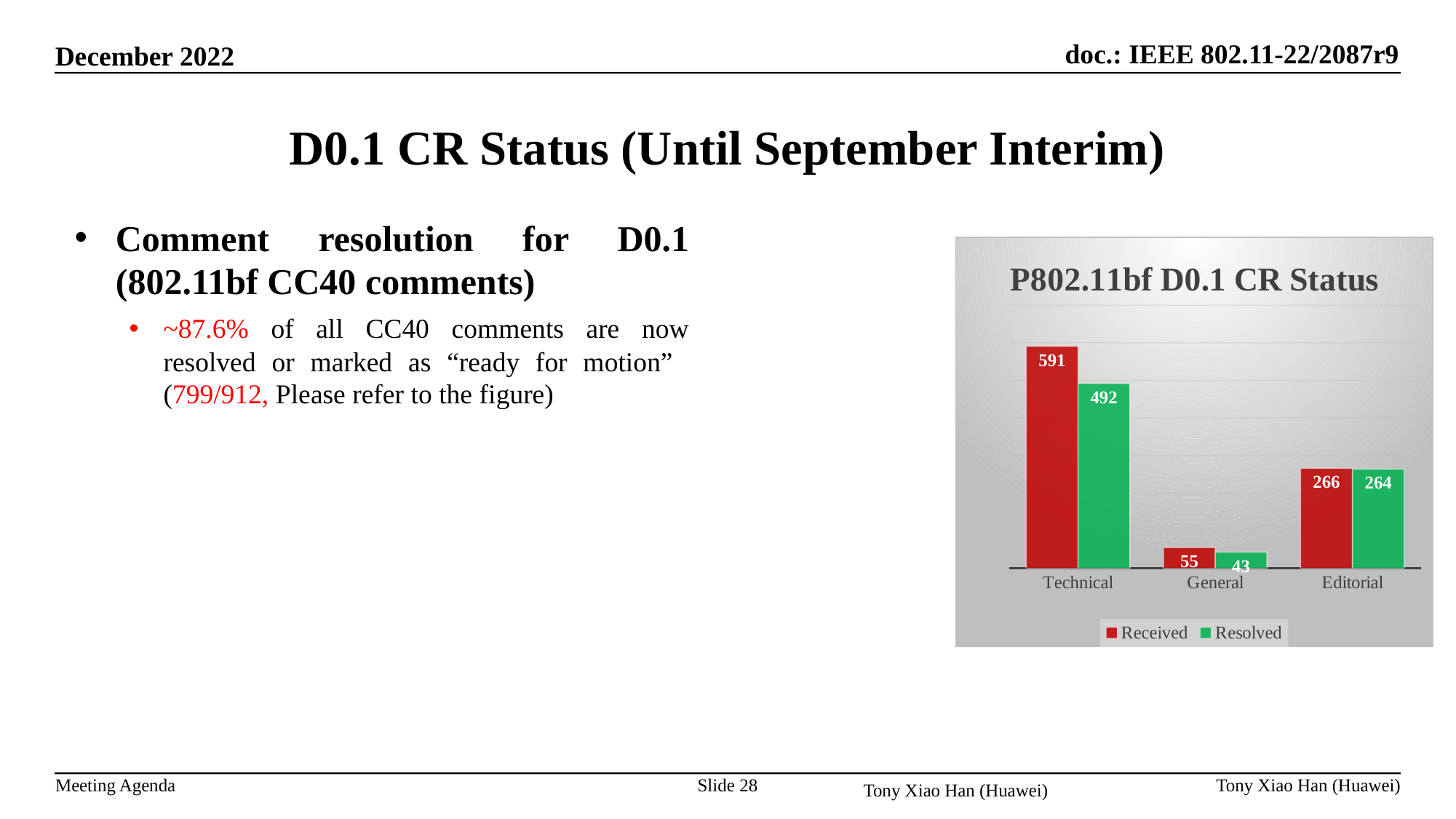
What is the difference between Received and Resolved for General? 12 Which category has the lowest Resolved value? General What is the Resolved value for Editorial? 264 What kind of chart is shown? Bar chart Which is larger, the Resolved value for Technical or the Received value for Editorial? Resolved value for Technical How many categories are shown on the x axis? 3 Which category has the highest Received value? Technical What is the title of the chart? P802.11bf D0.1 CR Status What is the Resolved value for General? 43 What is the difference between Received and Resolved for Technical? 99 What is the Received value for Technical? 591 How many series does the legend list? 2